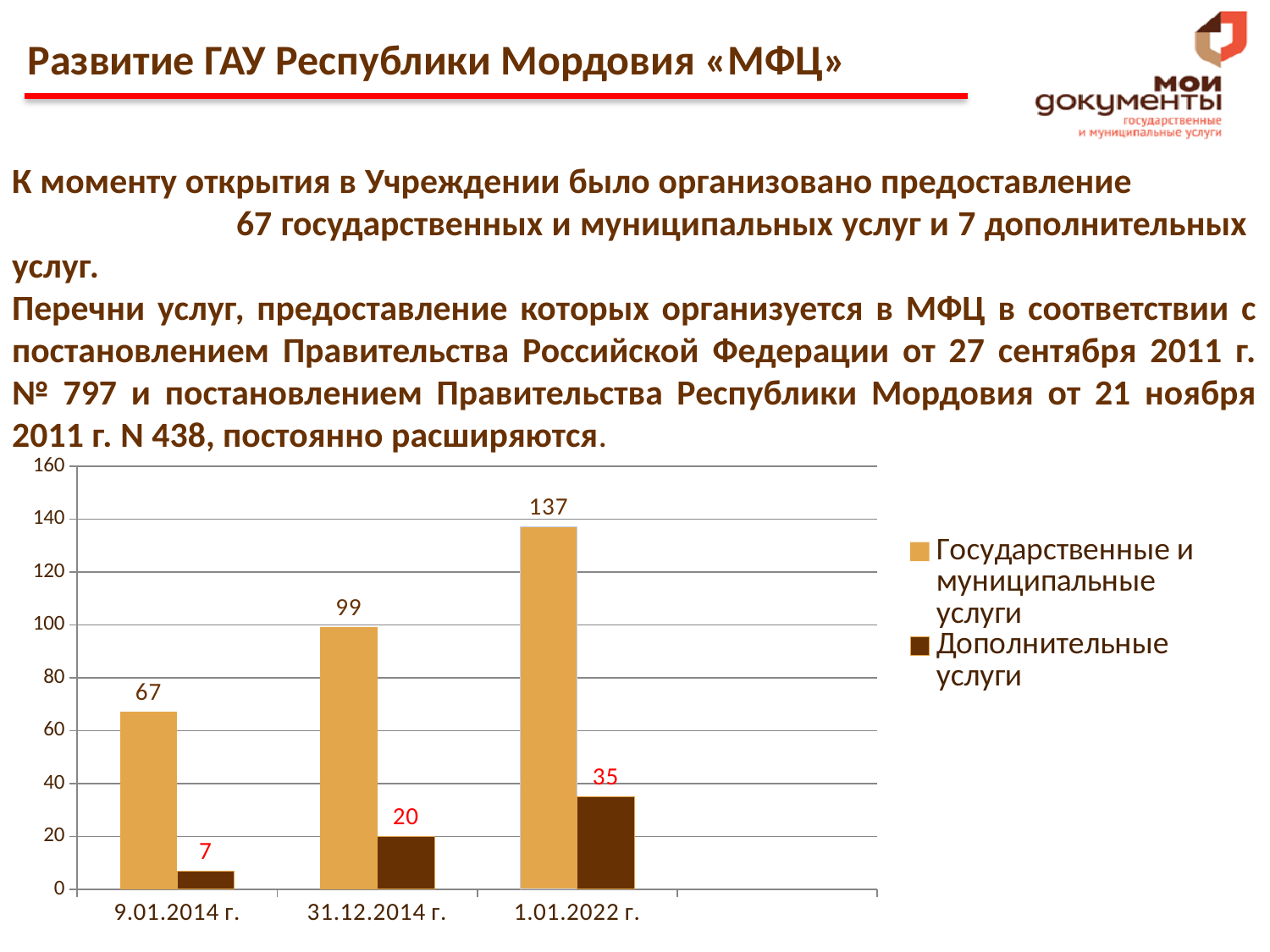
Which is larger: Дополнительные услуги on 31.12.2014 г. or on 9.01.2014 г.? 31.12.2014 г. On which date is the value for Дополнительные услуги lowest? 9.01.2014 г. How many series does the legend list? 2 What is the difference between Государственные и муниципальные услуги on 1.01.2022 г. and on 31.12.2014 г.? 38 What is the value for Дополнительные услуги on 31.12.2014 г.? 20 On which date is the value for Государственные и муниципальные услуги highest? 1.01.2022 г. What is the value for Государственные и муниципальные услуги on 1.01.2022 г.? 137 How many dates are shown on the x axis? 3 Is the value for Государственные и муниципальные услуги on 31.12.2014 г. greater or less than 80? greater What is the value for Дополнительные услуги on 1.01.2022 г.? 35 What kind of chart is shown on the slide? bar chart What is the value for Государственные и муниципальные услуги on 9.01.2014 г.? 67